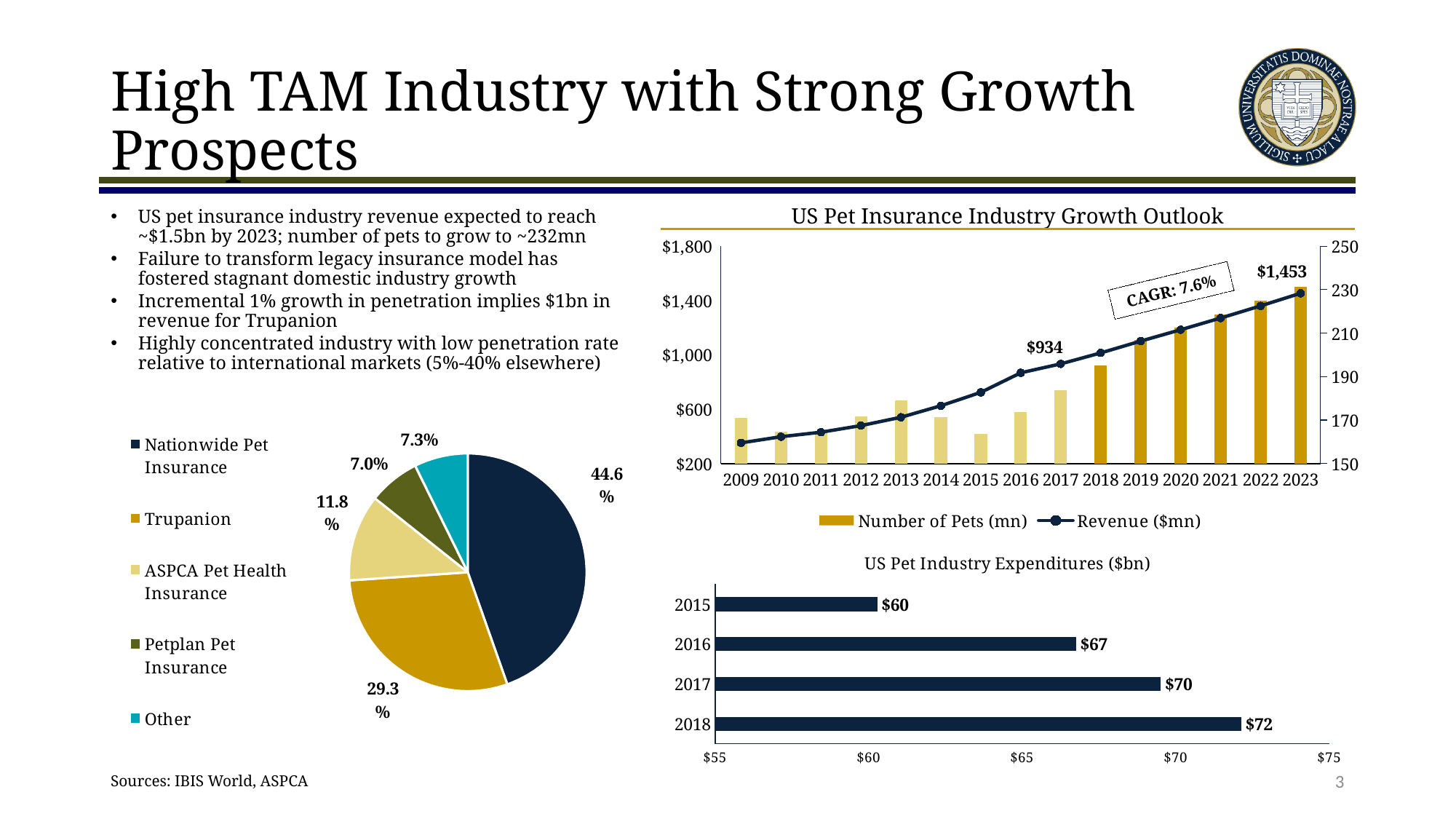
How many years are shown on the x axis of the US Pet Insurance Industry Growth Outlook chart? 15 In the pie chart on the left of the slide, which slice is the largest? Nationwide Pet Insurance What CAGR is annotated on the US Pet Insurance Industry Growth Outlook chart? 7.6% In the US Pet Insurance Industry Growth Outlook chart, what is the Revenue ($mn) value labelled for 2017? $934 In the US Pet Industry Expenditures ($bn) chart, which year has the lowest value? 2015 In the pie chart on the left of the slide, what share does Trupanion have? 29.3% What kind of chart is the US Pet Industry Expenditures ($bn) chart? bar chart In the US Pet Industry Expenditures ($bn) chart, what is the difference between the 2018 and 2015 values? $12 In the US Pet Insurance Industry Growth Outlook chart, what is the Revenue ($mn) value labelled for 2023? $1,453 In the US Pet Industry Expenditures ($bn) chart, do the values rise or fall from 2015 to 2018? rise In the US Pet Industry Expenditures ($bn) chart, what is the value for 2018? $72 How many series does the legend of the US Pet Insurance Industry Growth Outlook chart list? 2